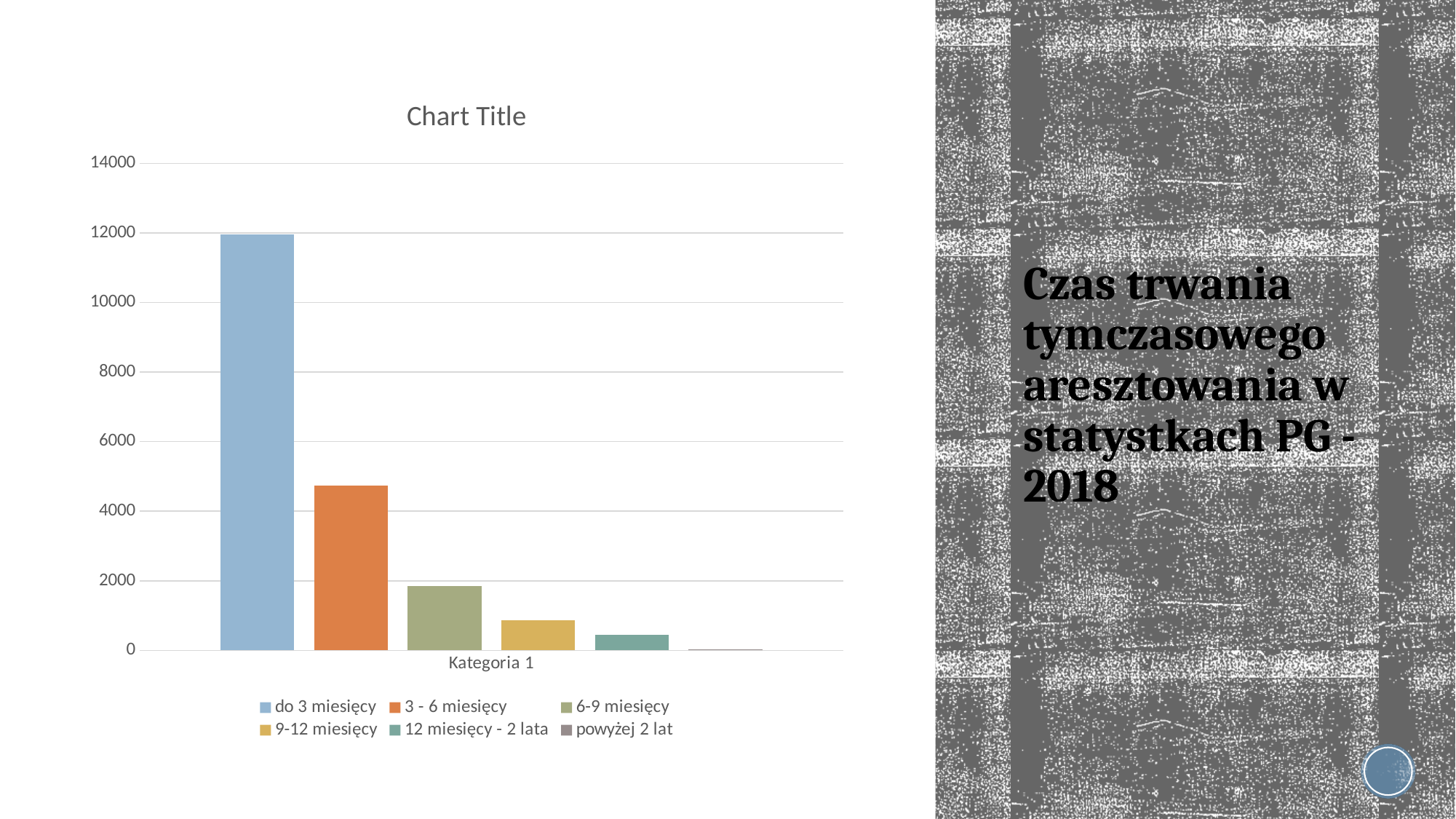
Is the value for 'do 3 miesięcy' greater or less than 10000? greater Which series has the highest value in the chart? do 3 miesięcy Is the value for '3 - 6 miesięcy' greater or less than 6000? less What is the title shown above the chart? Chart Title Is the value for '6-9 miesięcy' greater or less than 2000? less How many series does the chart legend list? 6 Which is larger, the value for '12 miesięcy - 2 lata' or the value for 'powyżej 2 lat'? 12 miesięcy - 2 lata Which series has the lowest value in the chart? powyżej 2 lat What kind of chart is shown on the slide? bar chart Do the bar values rise or fall from left to right across the chart? fall Which is larger, the value for '3 - 6 miesięcy' or the value for '6-9 miesięcy'? 3 - 6 miesięcy